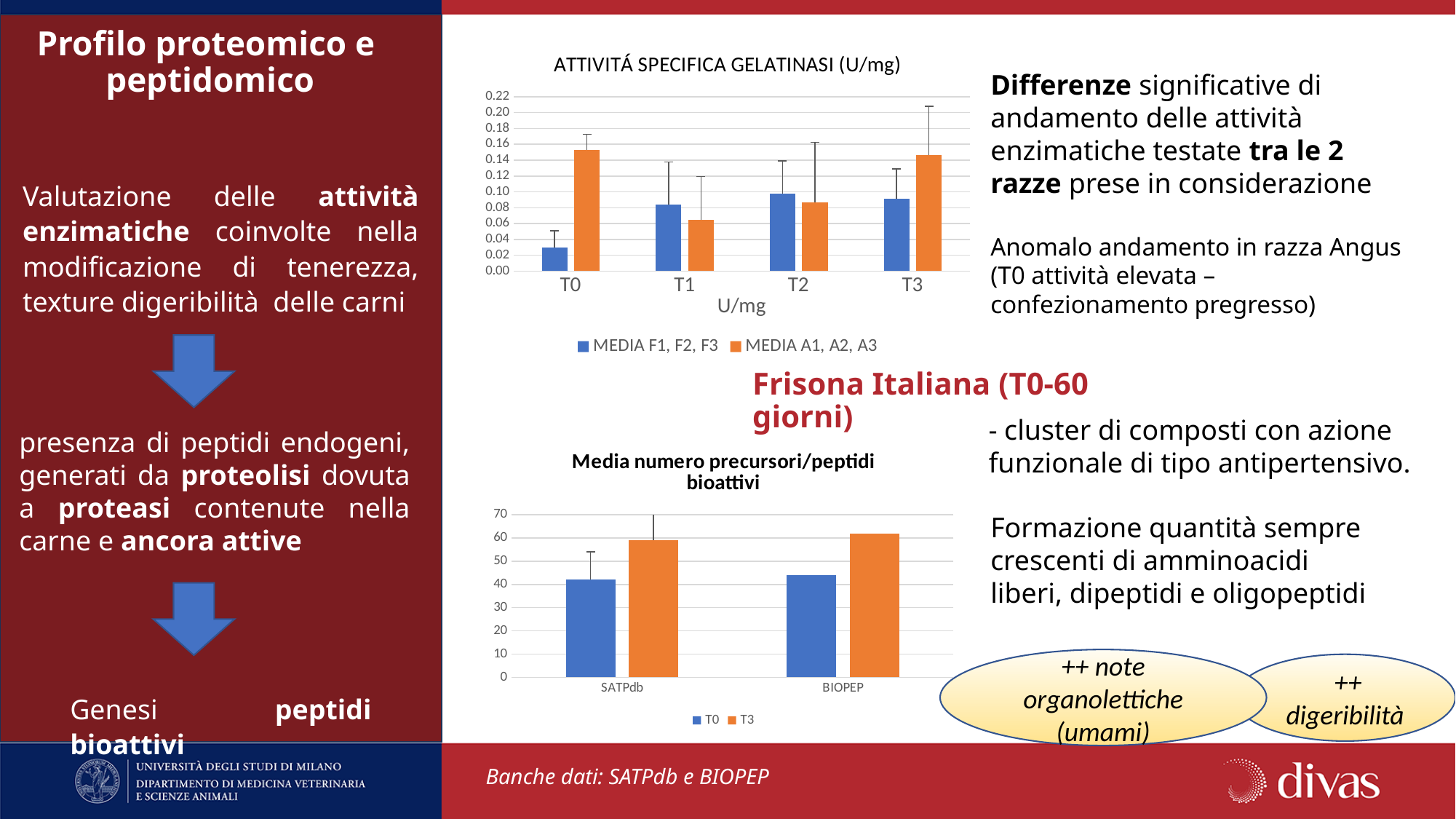
What kind of chart is the top chart titled 'ATTIVITÁ SPECIFICA GELATINASI (U/mg)'? Bar chart In the top chart 'ATTIVITÁ SPECIFICA GELATINASI (U/mg)', which category has the lowest value for the series MEDIA A1, A2, A3? T1 In the top chart 'ATTIVITÁ SPECIFICA GELATINASI (U/mg)', is the value for MEDIA F1, F2, F3 at T0 greater or less than 0.04? less In the top chart 'ATTIVITÁ SPECIFICA GELATINASI (U/mg)', which category has the lowest value for the series MEDIA F1, F2, F3? T0 What kind of chart is the bottom chart titled 'Media numero precursori/peptidi bioattivi'? Bar chart In the bottom chart 'Media numero precursori/peptidi bioattivi', for SATPdb which series has the larger value, T0 or T3? T3 How many categories are shown on the x axis of the top chart 'ATTIVITÁ SPECIFICA GELATINASI (U/mg)'? 4 How many series does the legend of the top chart 'ATTIVITÁ SPECIFICA GELATINASI (U/mg)' list? 2 In the top chart 'ATTIVITÁ SPECIFICA GELATINASI (U/mg)', at T0 which series has the larger value, MEDIA F1, F2, F3 or MEDIA A1, A2, A3? MEDIA A1, A2, A3 In the top chart 'ATTIVITÁ SPECIFICA GELATINASI (U/mg)', is the value for MEDIA A1, A2, A3 at T0 greater or less than 0.14? greater In the bottom chart 'Media numero precursori/peptidi bioattivi', is the value for T0 at SATPdb greater or less than 50? less How many categories are shown on the x axis of the bottom chart 'Media numero precursori/peptidi bioattivi'? 2